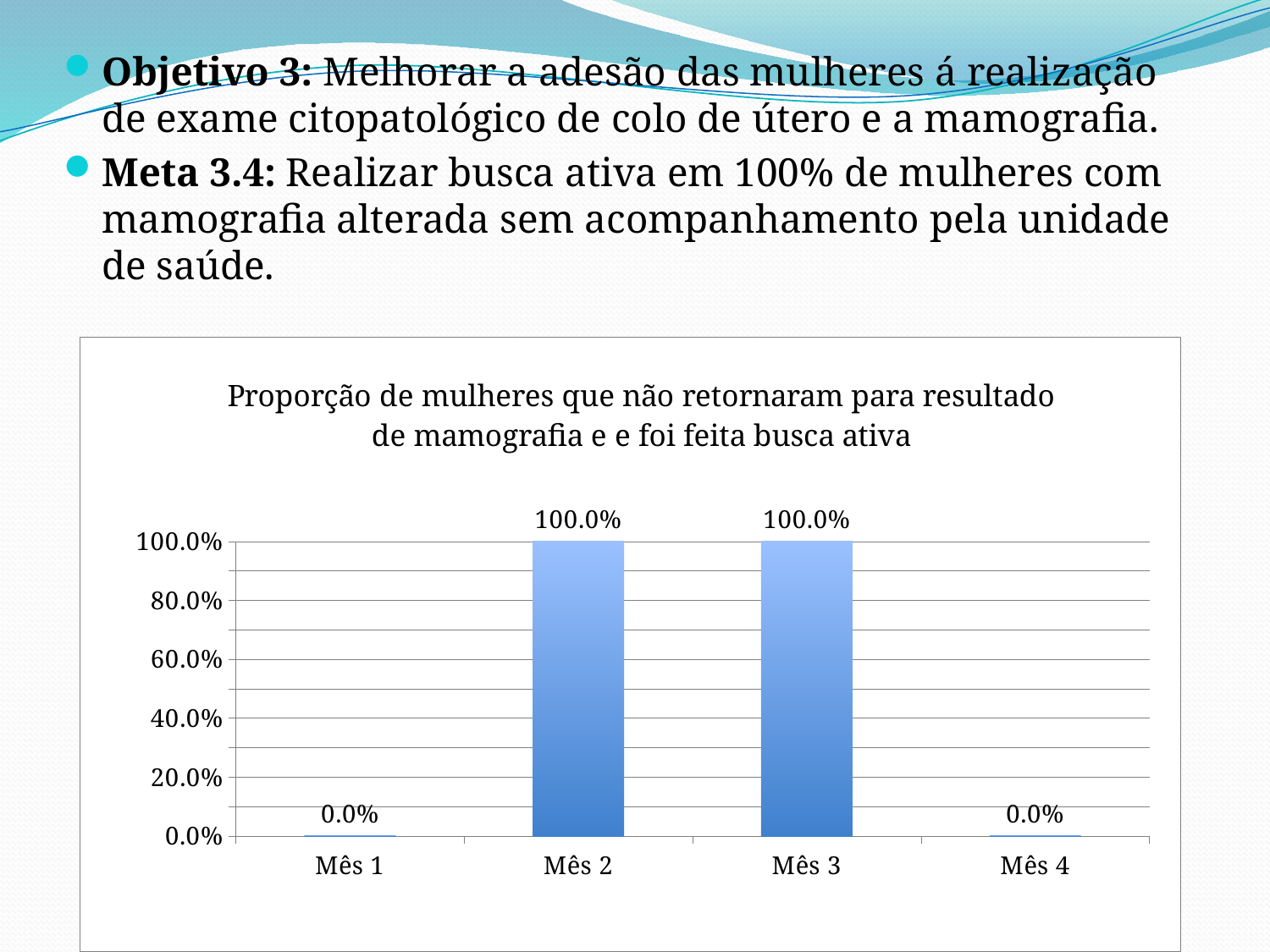
Which is larger, the value for Mês 3 or the value for Mês 4? Mês 3 What is the value for Mês 1? 0.0% What is the title of the chart? Proporção de mulheres que não retornaram para resultado de mamografia e e foi feita busca ativa How many categories are shown on the x axis? 4 What is the difference between the values for Mês 2 and Mês 1? 100.0% What is the value for Mês 2? 100.0% Is the value for Mês 4 greater or less than 20.0%? less How many months have a value of 100.0%? 2 Is the value for Mês 2 greater or less than 80.0%? greater What kind of chart is shown on the slide? bar chart What is the value for Mês 4? 0.0% What is the value for Mês 3? 100.0%